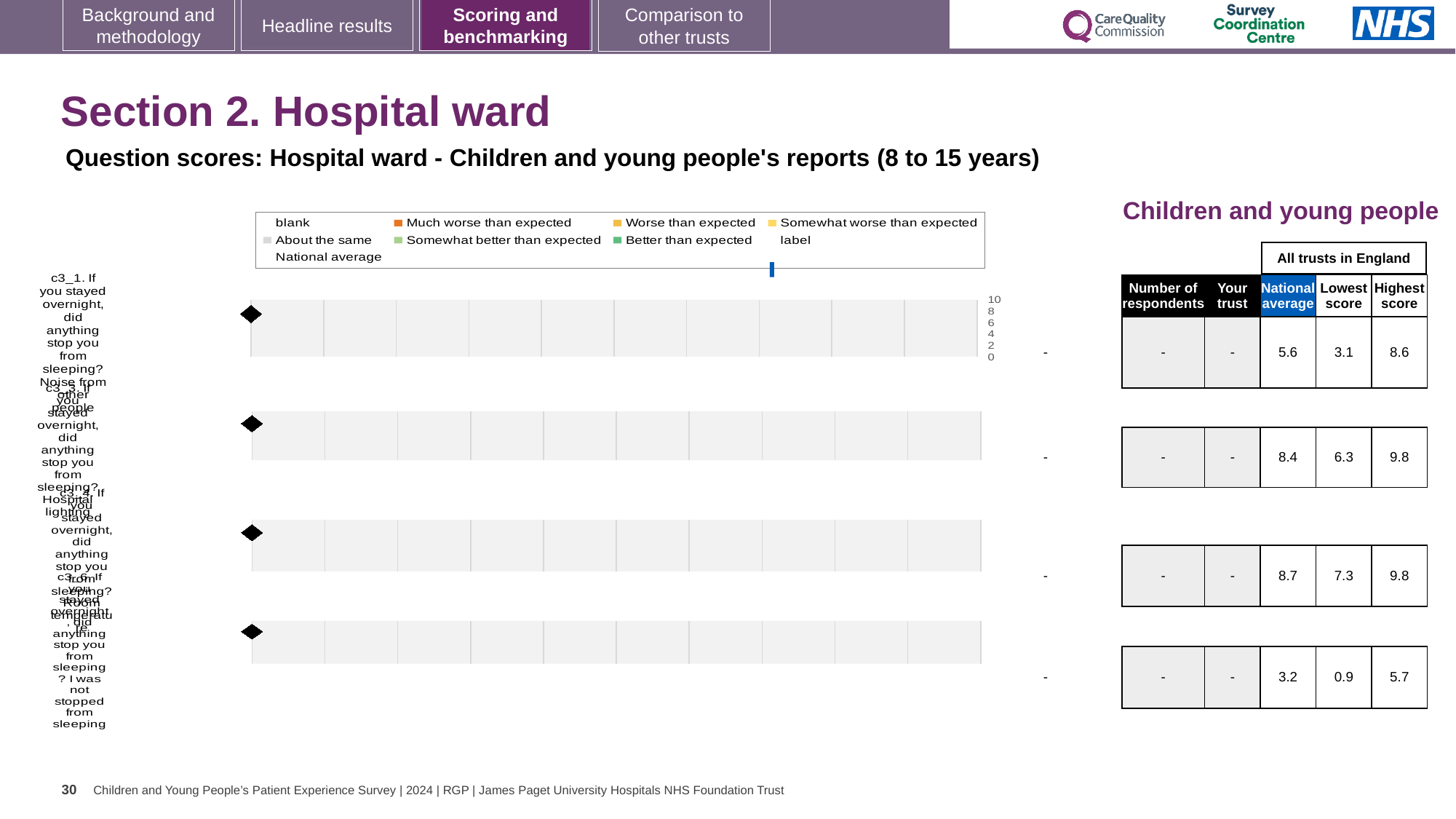
What is the highest value shown on the chart's axis? 10 In the table, what is the Lowest score for the fourth question row (c3_6, I was not stopped from sleeping)? 0.9 In the table, what is the difference between the Highest score and Lowest score for the first question row (c3_1)? 5.5 In the table, is the National average for the third question row (c3_4) larger or smaller than that for the second row (c3_3)? larger How many entries does the chart's legend list? 9 In the table, what is the National average for the first question row (c3_1, noise from other people)? 5.6 In the table, which question row has the lowest National average? c3_6 (I was not stopped from sleeping), 3.2 In the table, which question row has the highest National average? c3_4 (room temperature), 8.7 What kind of chart is shown on the slide? bar chart How many bars (question rows) does the chart contain? 4 In the table, what is the Highest score for the second question row (c3_3, hospital lighting)? 9.8 Which legend entry is shown with an orange marker? Much worse than expected